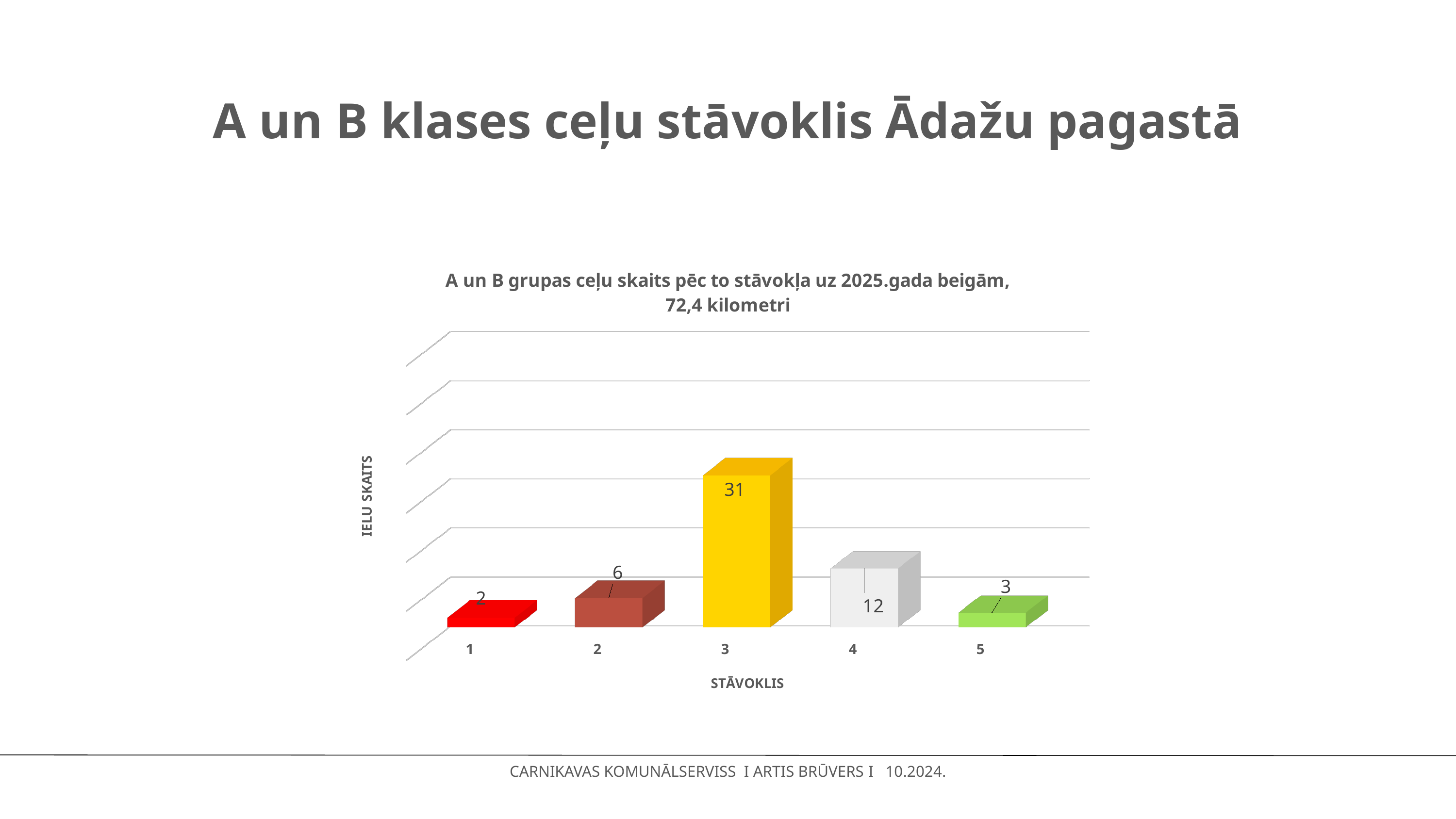
What is the difference between the values for condition 3 and condition 4? 19 Which condition category has the highest number of streets? 3 Which condition category has the lowest number of streets? 1 What is the value for condition 4? 12 What kind of chart is shown? bar chart What is the value for condition 1? 2 Which is larger, the value for condition 2 or condition 5? condition 2 What is the label of the y axis? IELU SKAITS What is the value for condition 5? 3 How many condition categories are shown on the x axis? 5 What is the title of the chart? A un B grupas ceļu skaits pēc to stāvokļa uz 2025.gada beigām, 72,4 kilometri What is the value for condition (STĀVOKLIS) 3? 31